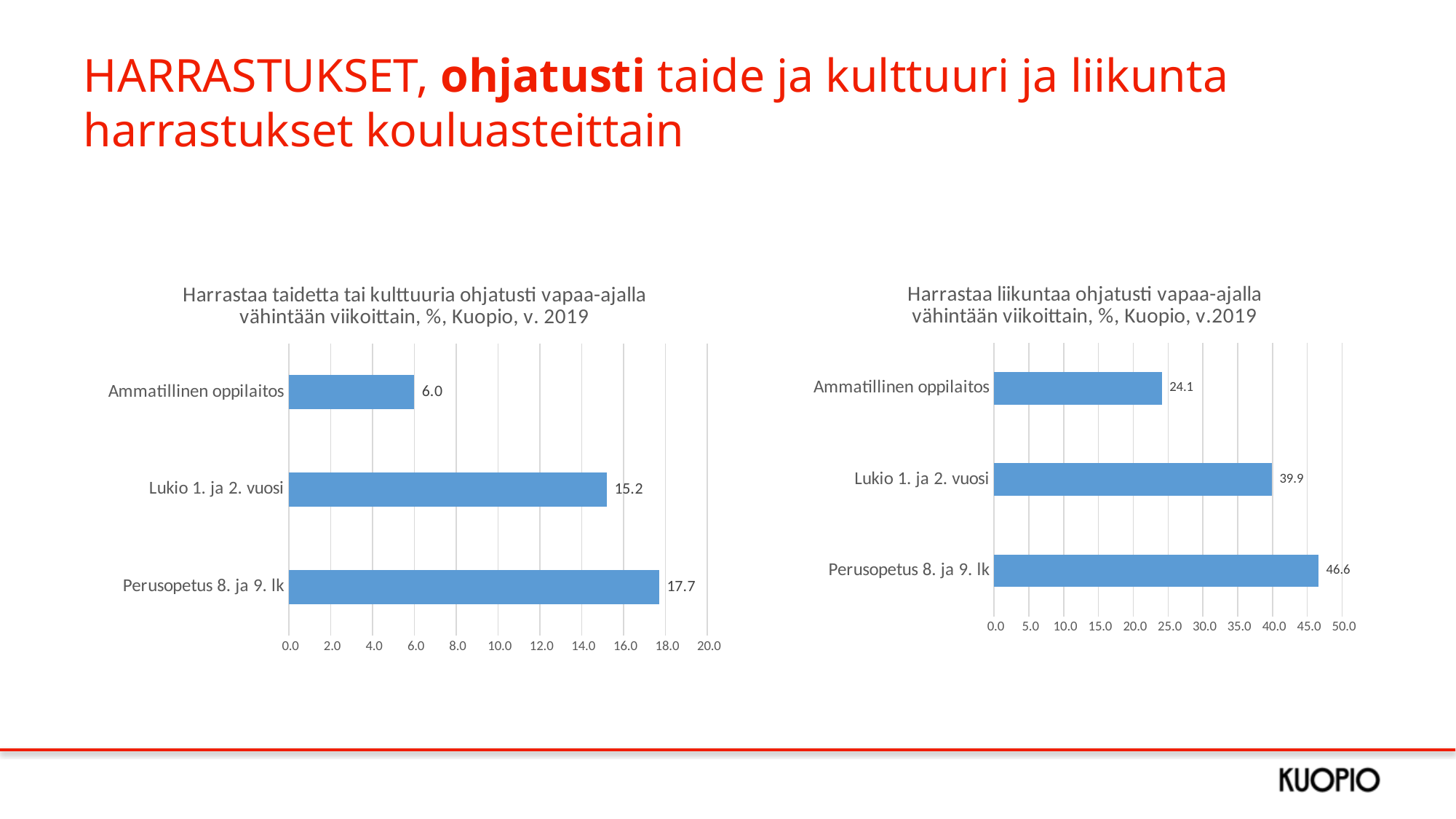
In the right chart (Harrastaa liikuntaa ohjatusti), what is the value for Ammatillinen oppilaitos? 24.1 In the left chart (Harrastaa taidetta tai kulttuuria ohjatusti), what is the difference between Perusopetus 8. ja 9. lk and Ammatillinen oppilaitos? 11.7 In the right chart (Harrastaa liikuntaa ohjatusti), which is larger: Lukio 1. ja 2. vuosi or Ammatillinen oppilaitos? Lukio 1. ja 2. vuosi In the left chart (Harrastaa taidetta tai kulttuuria ohjatusti), what is the value for Lukio 1. ja 2. vuosi? 15.2 What is the maximum value shown on the x axis of the right chart (Harrastaa liikuntaa ohjatusti)? 50.0 In the left chart (Harrastaa taidetta tai kulttuuria ohjatusti), which category has the highest value? Perusopetus 8. ja 9. lk In the right chart (Harrastaa liikuntaa ohjatusti), what is the value for Perusopetus 8. ja 9. lk? 46.6 What kind of chart is the left chart (Harrastaa taidetta tai kulttuuria ohjatusti)? Bar chart In the right chart (Harrastaa liikuntaa ohjatusti), what is the difference between Perusopetus 8. ja 9. lk and Lukio 1. ja 2. vuosi? 6.7 How many categories are shown in the right chart (Harrastaa liikuntaa ohjatusti)? 3 In the left chart (Harrastaa taidetta tai kulttuuria ohjatusti), is the value for Lukio 1. ja 2. vuosi greater or less than 10.0? greater In the right chart (Harrastaa liikuntaa ohjatusti), which category has the lowest value? Ammatillinen oppilaitos